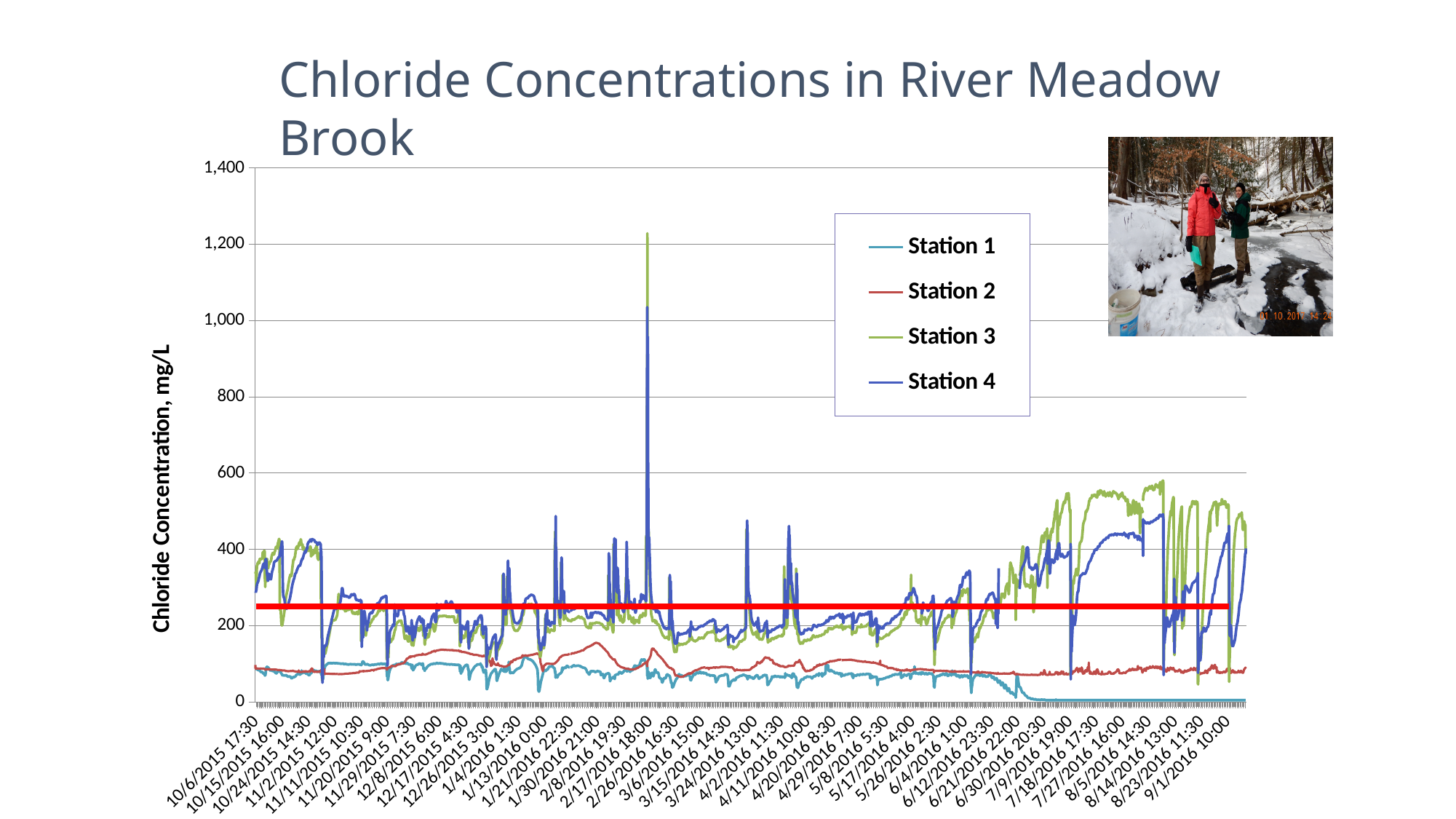
How many series does the legend list? 4 Is the highest value for Station 2 greater or less than 200? less Is the peak of Station 4 near 2/26/2016 greater or less than 800? greater What kind of chart is shown on the slide? line chart Is the highest peak of Station 3 greater or less than 1,200? greater Around 7/27/2016, which is higher, Station 3 or Station 2? Station 3 What is the label on the vertical axis? Chloride Concentration, mg/L What is the title of the chart? Chloride Concentrations in River Meadow Brook Which station has the lowest values at the right end of the chart (around 9/1/2016)? Station 1 Which station reaches the highest peak value on the chart? Station 3 Does the Station 1 line rise or fall between 6/21/2016 and 9/1/2016? fall